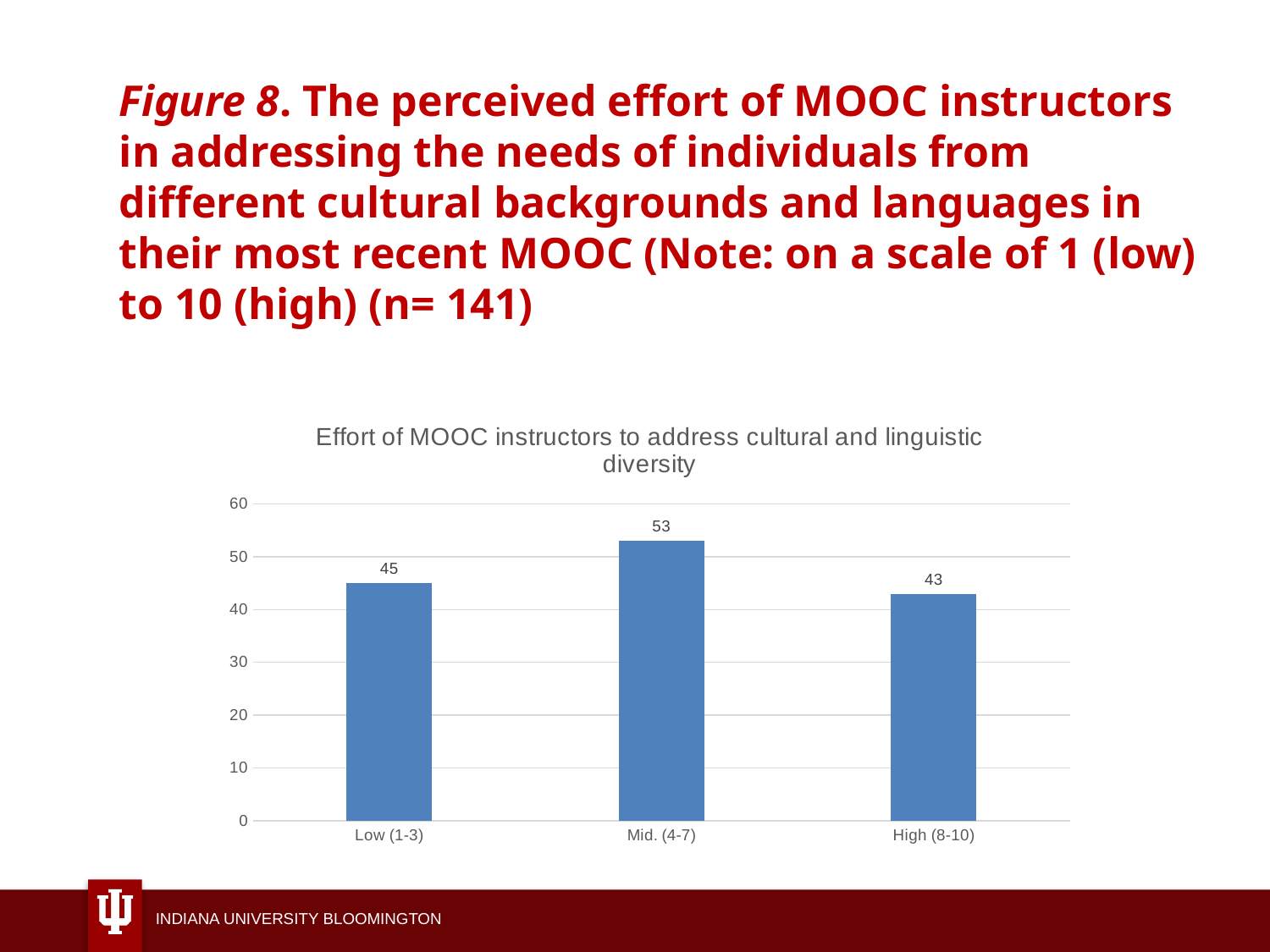
Which is larger, the value for Low (1-3) or the value for Mid. (4-7)? Mid. (4-7) What is the value for Mid. (4-7)? 53 What is the title of the chart? Effort of MOOC instructors to address cultural and linguistic diversity What kind of chart is shown on the slide? bar chart Which category has the highest value? Mid. (4-7) What is the value for Low (1-3)? 45 Which category has the lowest value? High (8-10) How many categories are shown on the x axis? 3 What is the value for High (8-10)? 43 What is the difference between the values for Mid. (4-7) and High (8-10)? 10 What is the difference between the values for Low (1-3) and High (8-10)? 2 Is the value for Mid. (4-7) greater or less than 50? greater